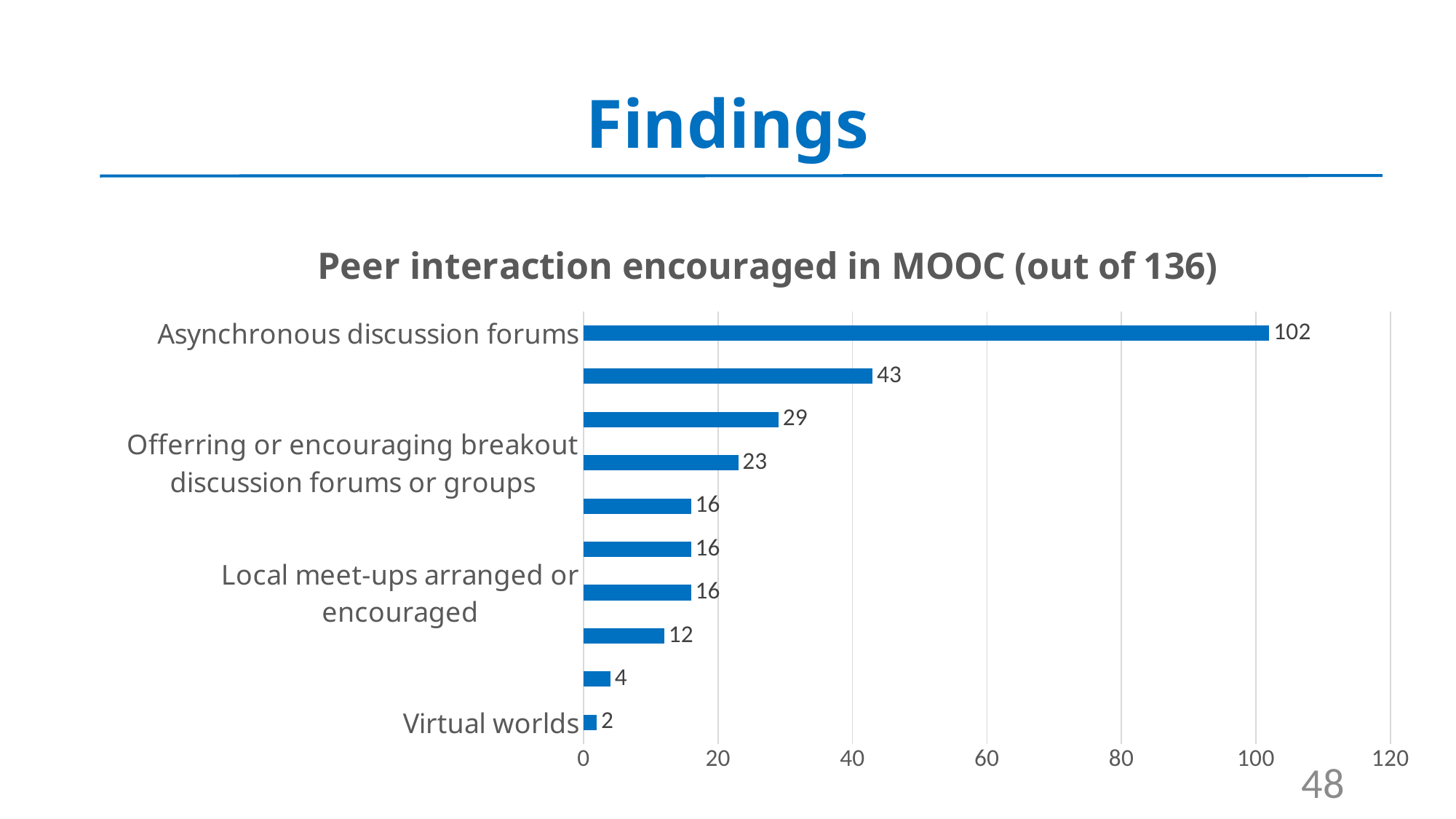
What kind of chart is shown on the slide? bar chart What is the difference between the values for Offerring or encouraging breakout discussion forums or groups and Local meet-ups arranged or encouraged? 7 What is the value for Virtual worlds? 2 How many bars are plotted in the chart? 10 Is the value for Asynchronous discussion forums greater or less than 100? greater Which category has the highest value? Asynchronous discussion forums What is the difference between the values for Asynchronous discussion forums and Virtual worlds? 100 What is the value for Local meet-ups arranged or encouraged? 16 What is the value for Offerring or encouraging breakout discussion forums or groups? 23 What is the value for Asynchronous discussion forums? 102 Which category has the lowest value? Virtual worlds Which is larger: the value for Offerring or encouraging breakout discussion forums or groups or the value for Local meet-ups arranged or encouraged? Offerring or encouraging breakout discussion forums or groups